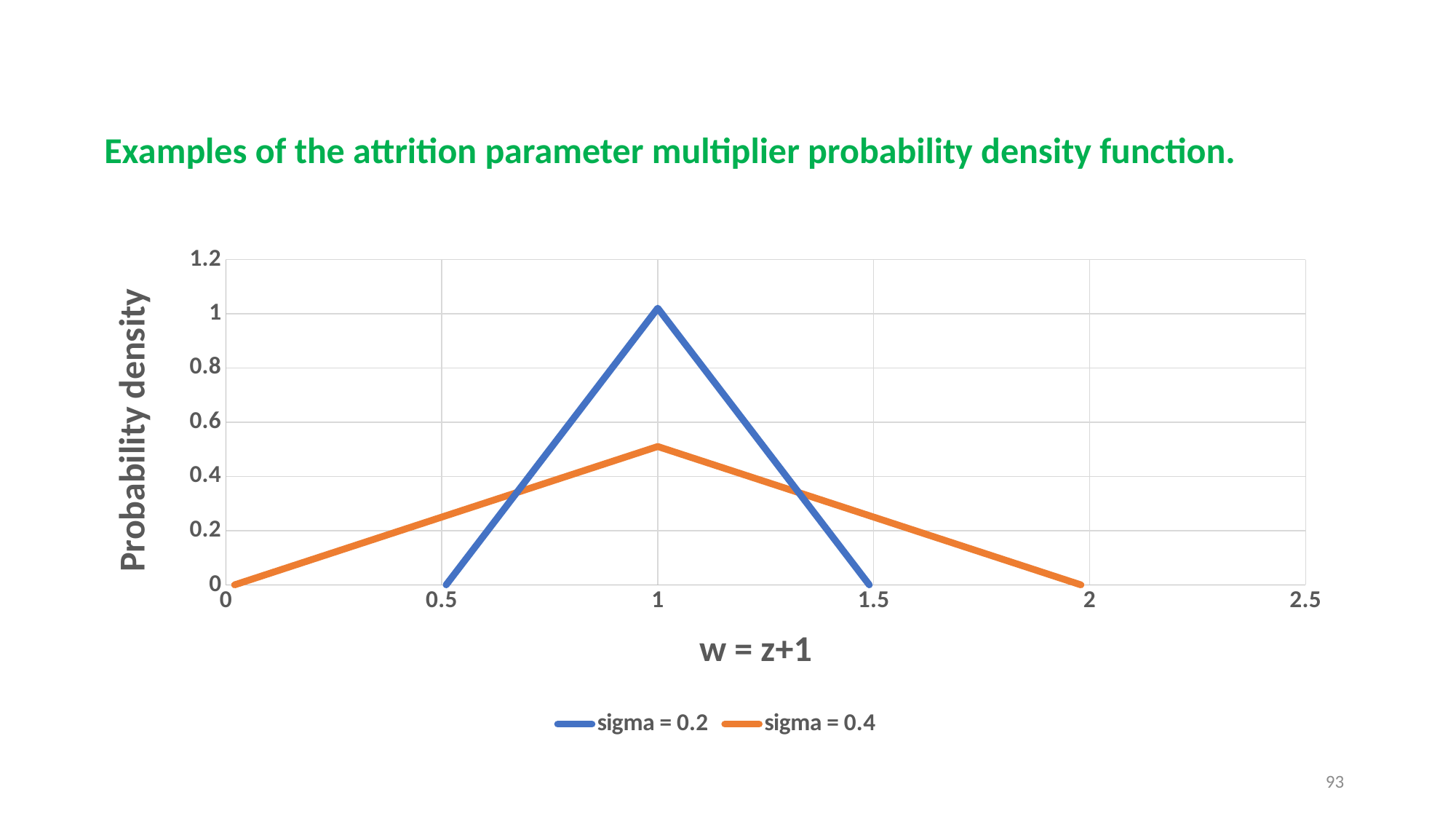
Which series reaches the higher peak probability density? sigma = 0.2 Is the peak value of the sigma = 0.4 series greater or less than 0.4? greater What kind of chart is shown on the slide? line chart Is the peak value of the sigma = 0.2 series greater or less than 0.8? greater What is the probability density of the sigma = 0.4 series at w = 2? 0 Which colour is used for the sigma = 0.4 series? orange Is the peak value of the sigma = 0.4 series greater or less than 0.6? less Do the values of the sigma = 0.2 series rise or fall as w goes from 1 to 1.5? fall At w = 1, which series has the larger probability density, sigma = 0.2 or sigma = 0.4? sigma = 0.2 What is the label of the x axis? w = z+1 What is the probability density of the sigma = 0.2 series at w = 0.5? 0 How many series does the legend list? 2